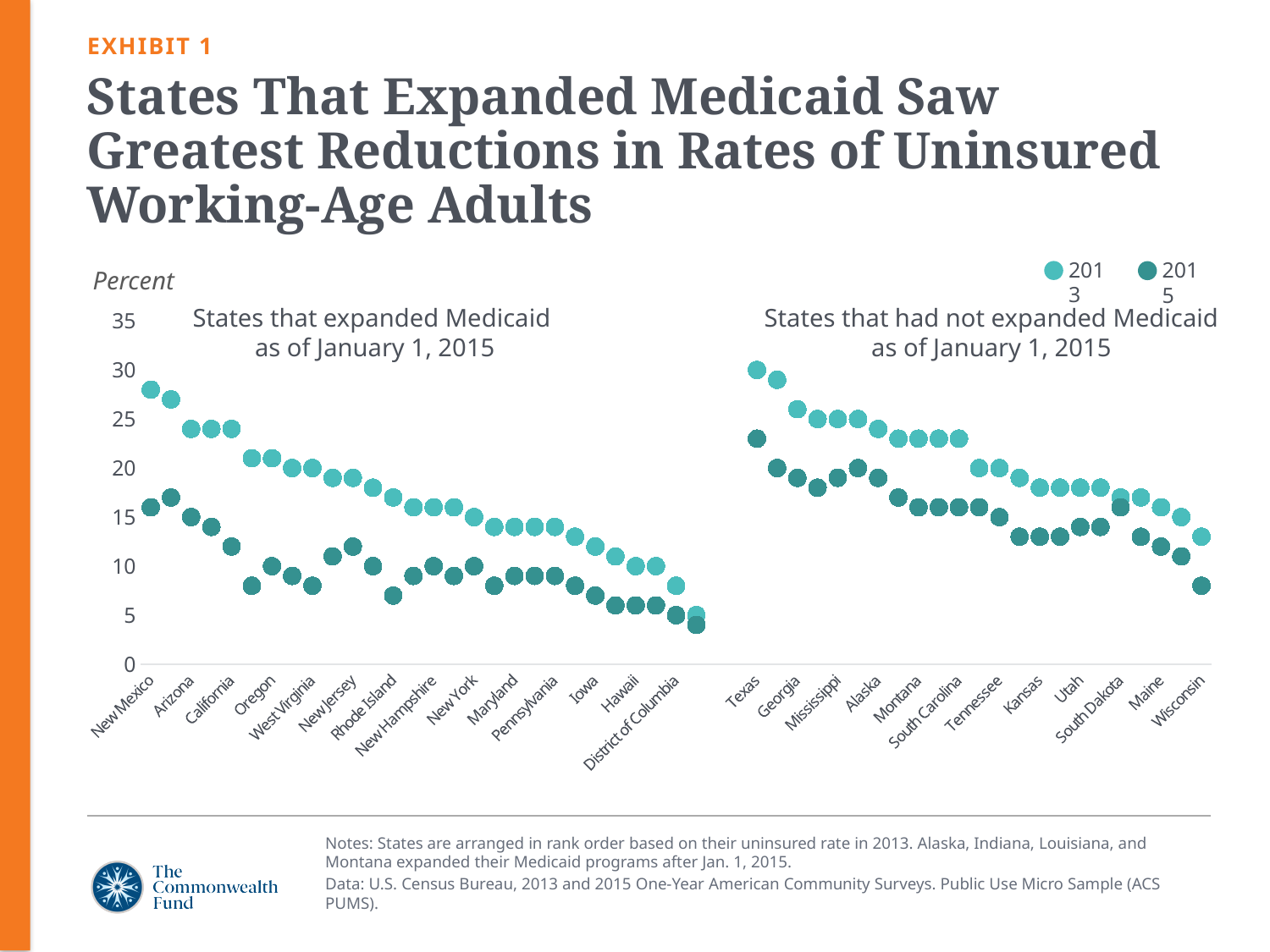
Which state has the highest 2013 uninsured rate in the right panel (states that had not expanded Medicaid)? Texas In the right panel (states that had not expanded Medicaid), is the 2015 value for Wisconsin greater or less than 10? less In the left panel (states that expanded Medicaid), is the 2013 value for District of Columbia greater or less than 10? less Which two years are shown in the legend? 2013 and 2015 In the left panel (states that expanded Medicaid), is the 2013 value for New Mexico greater or less than 25? greater What is the title of the left panel of the chart? States that expanded Medicaid as of January 1, 2015 Which is larger: the 2015 value for Texas in the right panel or the 2015 value for New Mexico in the left panel? Texas What kind of chart is shown on the slide? Dot (scatter) chart How many series does the legend list? 2